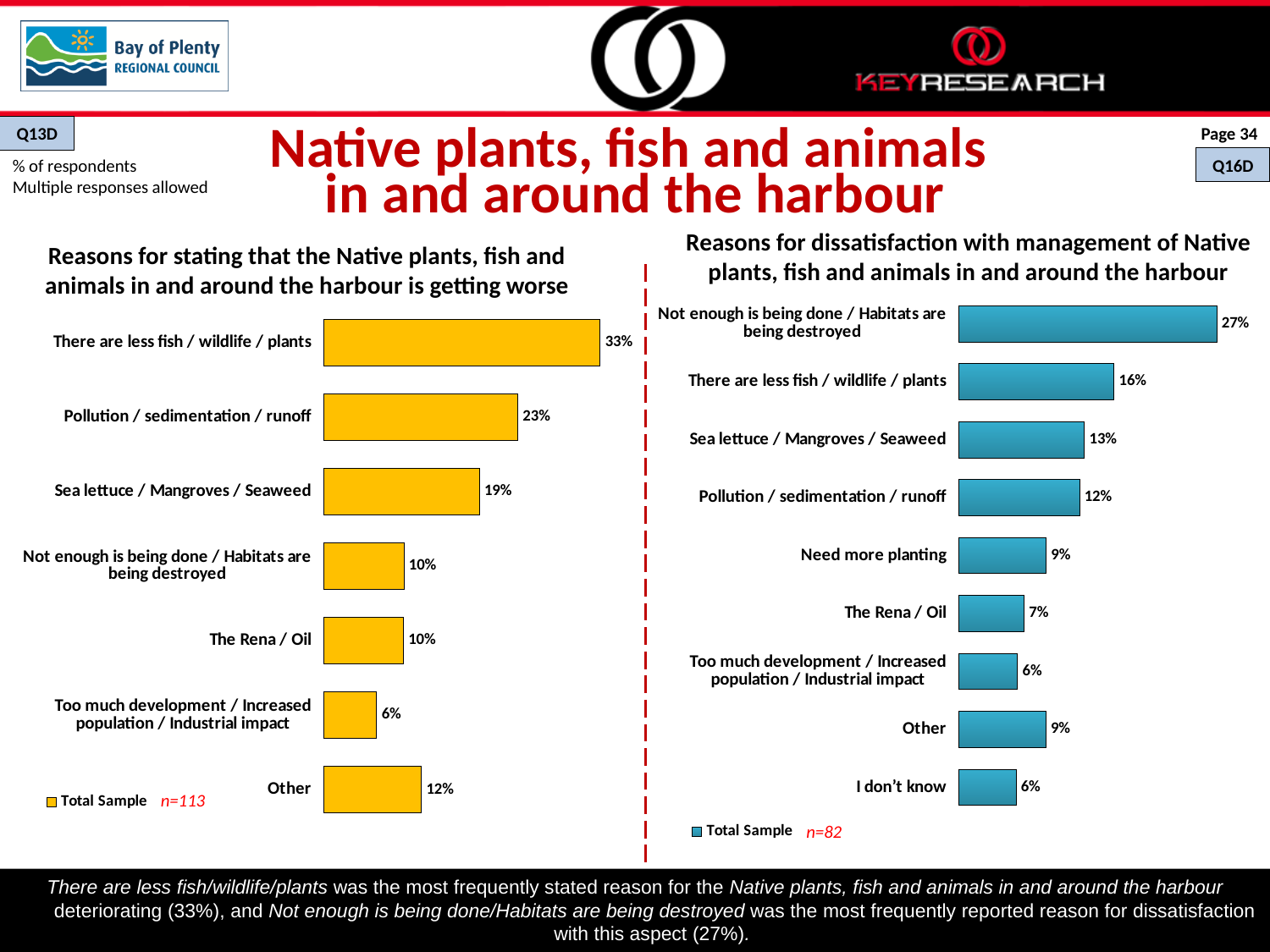
How many categories are shown in the right chart (reasons for dissatisfaction with management)? 9 What sample size (n) is shown for the right chart (reasons for dissatisfaction with management)? n=82 What type of chart is the left chart (reasons for getting worse)? Bar chart In the right chart (reasons for dissatisfaction with management), which category has the highest value? Not enough is being done / Habitats are being destroyed In the left chart (reasons for getting worse), which category has the lowest value? Too much development / Increased population / Industrial impact In the left chart (reasons for getting worse), what is the difference between 'There are less fish / wildlife / plants' and 'Sea lettuce / Mangroves / Seaweed'? 14% In the right chart (reasons for dissatisfaction with management), which is larger: 'Sea lettuce / Mangroves / Seaweed' or 'The Rena / Oil'? Sea lettuce / Mangroves / Seaweed In the right chart (reasons for dissatisfaction with management), what is the difference between 'Not enough is being done / Habitats are being destroyed' and 'There are less fish / wildlife / plants'? 11% In the left chart (reasons for getting worse), what is the value for 'Pollution / sedimentation / runoff'? 23% How many categories are shown in the left chart (reasons for getting worse)? 7 In the right chart (reasons for dissatisfaction with management), what is the value for 'Need more planting'? 9% In the left chart (reasons for getting worse), which category has the highest value? There are less fish / wildlife / plants